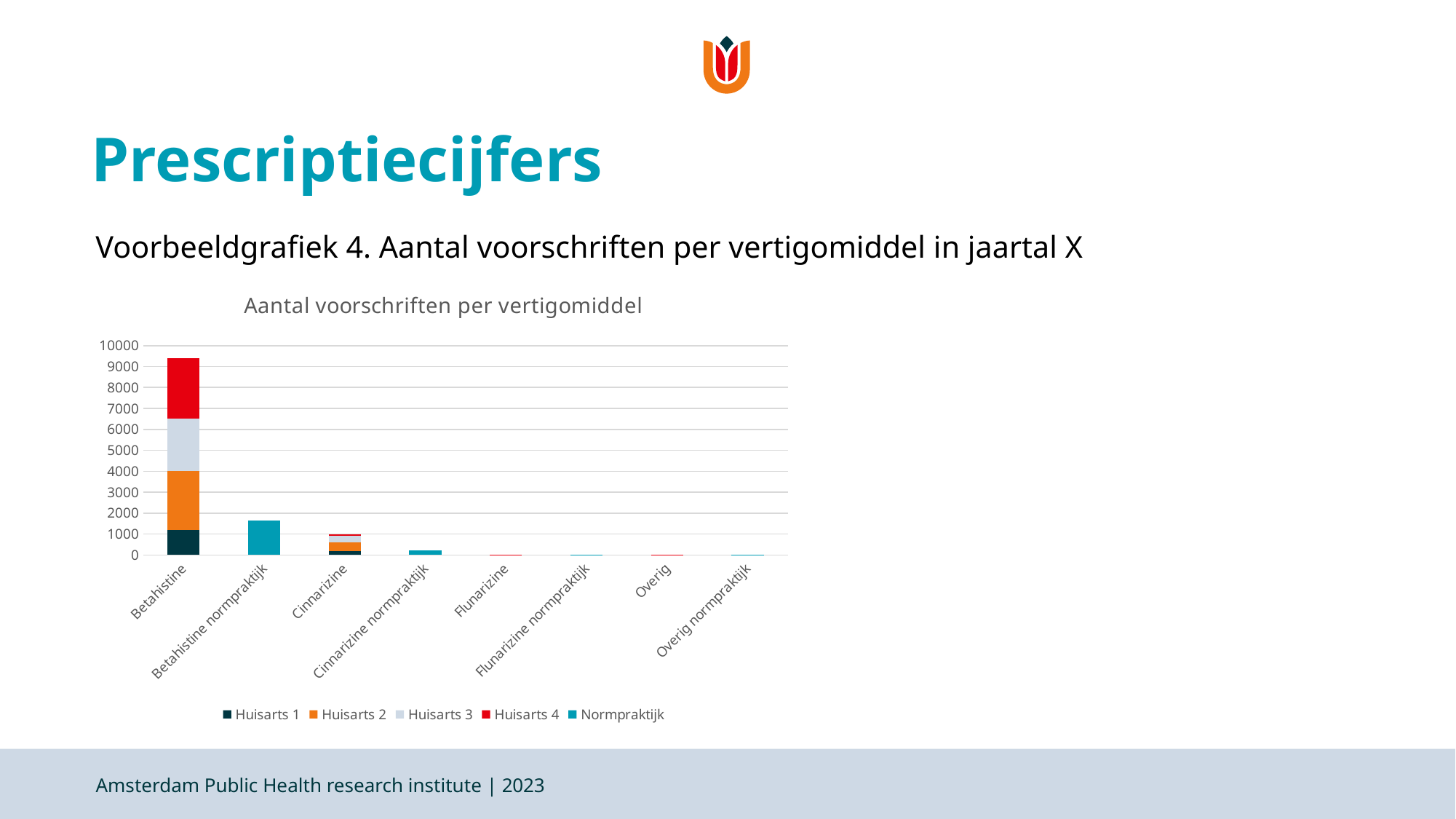
Is the value for Betahistine normpraktijk greater or less than 1000? greater Is the value for Betahistine normpraktijk greater or less than 2000? less What kind of chart is shown on the slide? stacked bar chart Which is larger, the total for Betahistine or the value for Betahistine normpraktijk? Betahistine How many categories are shown on the x axis? 8 Is the total value for Betahistine greater or less than 9000? greater Which category has the highest total number of prescriptions? Betahistine Which legend series is shown in red? Huisarts 4 What is the title of the chart? Aantal voorschriften per vertigomiddel How many series does the legend list? 5 Which is larger, the total for Cinnarizine or the value for Cinnarizine normpraktijk? Cinnarizine